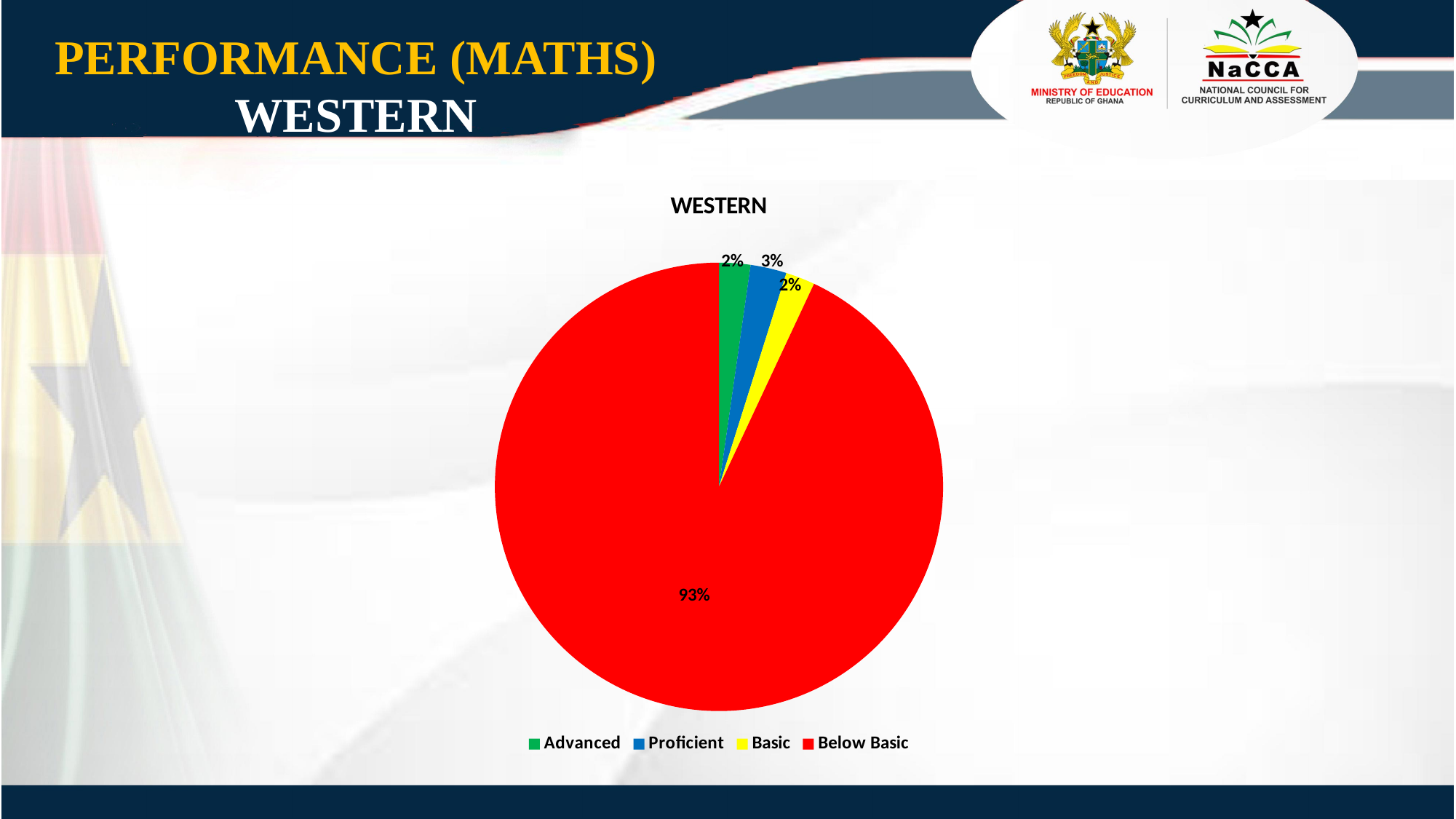
What percentage of the pie is Basic? 2% How many slices does the pie chart have? 4 What kind of chart is shown on the slide? pie chart How many categories does the legend list? 4 Which is larger, the Proficient share or the Advanced share? Proficient Which category has the largest share of the pie? Below Basic What percentage of the pie is Proficient? 3% Which colour represents Below Basic in the chart? red What percentage of the pie is Advanced? 2% What is the difference between the Below Basic share and the Proficient share? 90% What percentage of the pie is Below Basic? 93% What is the chart's title? WESTERN